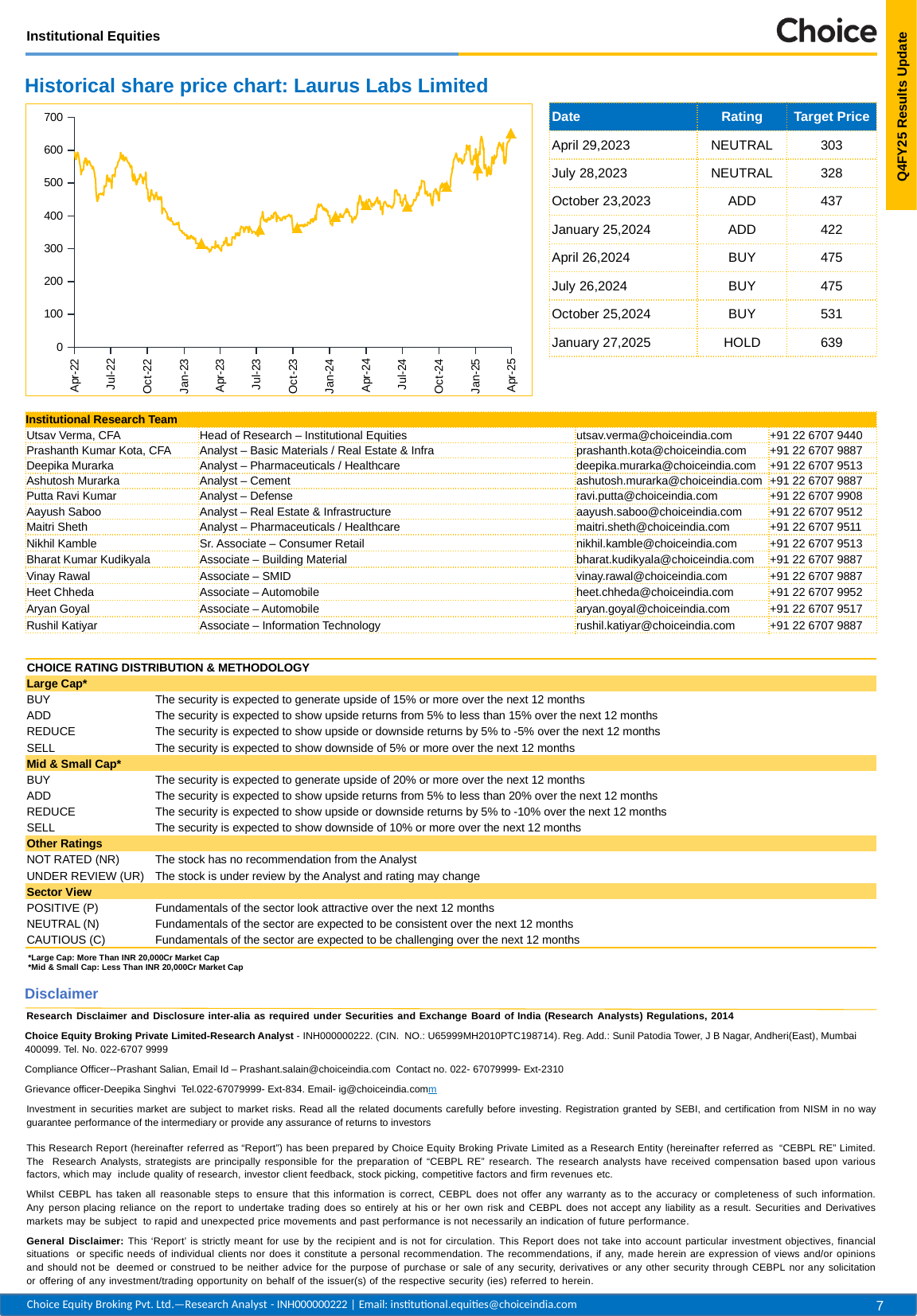
Does the share price rise or fall between Apr-22 and Apr-23? fall Is the share price at Apr-22 greater or less than 500? greater Near which x-axis label does the share price reach its lowest point? Apr-23 Is the share price at Apr-23 greater or less than 400? less Is the share price at Apr-25 greater or less than 600? greater Does the share price rise or fall between Jul-24 and Apr-25? rise Is the share price higher at Apr-25 or at Apr-23? Apr-25 What kind of chart is the Historical share price chart: Laurus Labs Limited? Line chart How many labelled points are there on the x axis of the share price chart? 13 What is the highest value shown on the y axis of the share price chart? 700 What is the title of the chart on the slide? Historical share price chart: Laurus Labs Limited